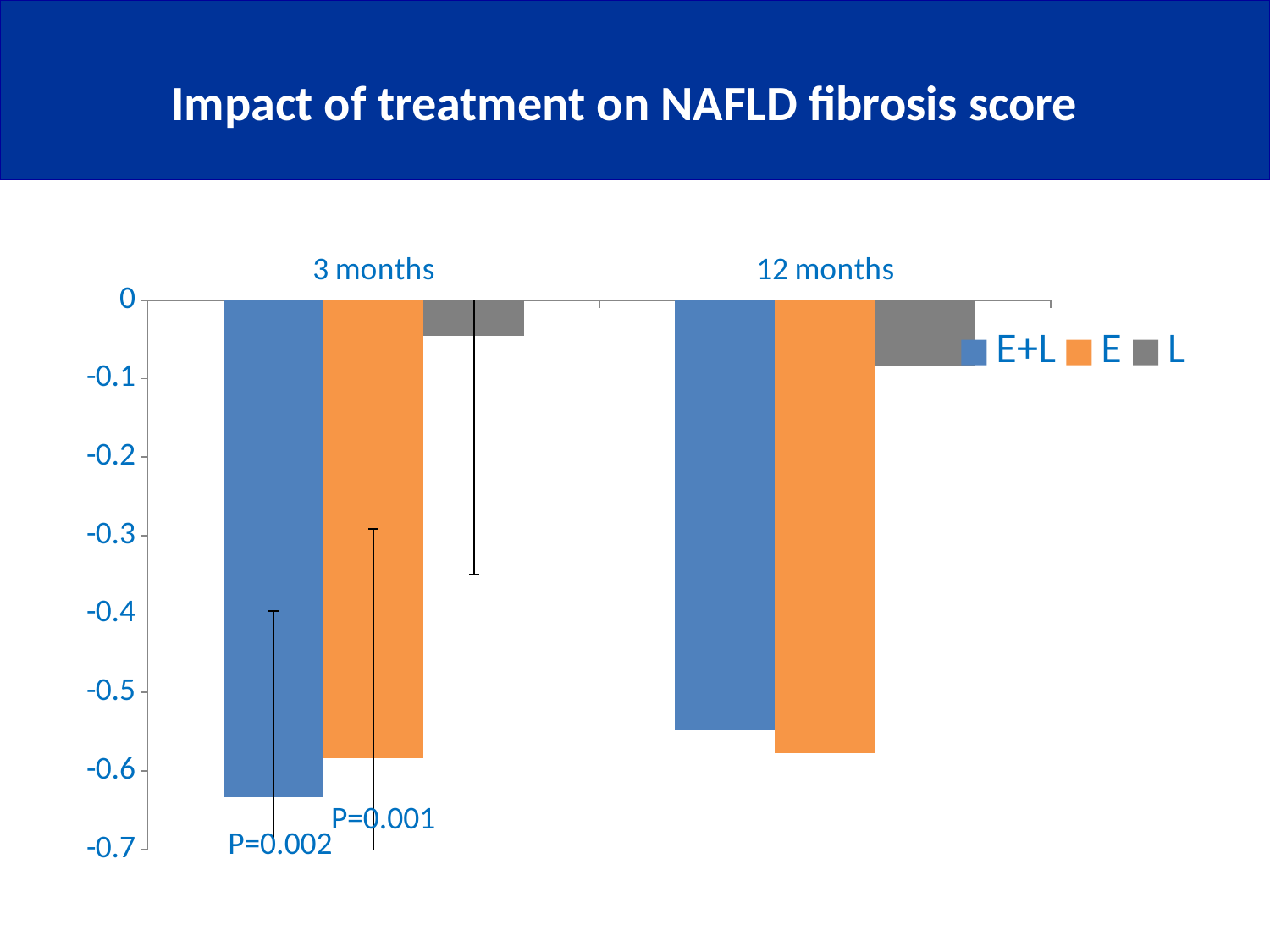
Is the value for E at 12 months greater or less than -0.5? less Is the value for E+L at 12 months greater or less than -0.6? greater Which series has the highest (least negative) value at 3 months? L Which series has the lowest (most negative) value at 3 months? E+L Is the value for E at 3 months greater or less than -0.6? greater How many time-point categories are shown on the x axis? 2 Does the value for E+L rise or fall from 3 months to 12 months? rise How many series does the legend list? 3 What kind of chart is shown on the slide? bar chart What is the title of the slide's chart? Impact of treatment on NAFLD fibrosis score